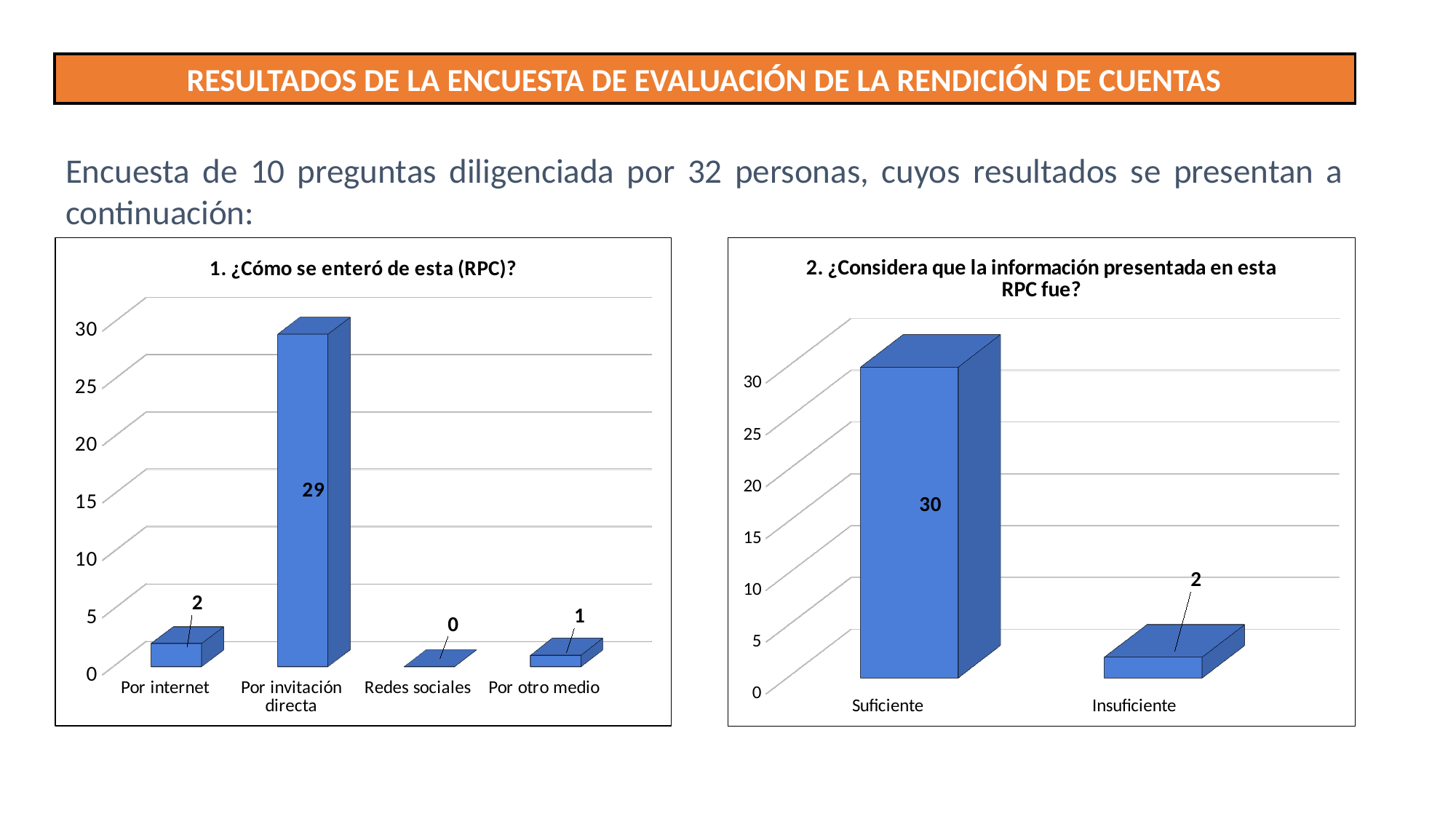
In the chart titled "1. ¿Cómo se enteró de esta (RPC)?", which is larger, "Por internet" or "Por otro medio"? Por internet In the chart titled "2. ¿Considera que la información presentada en esta RPC fue?", what is the value for "Insuficiente"? 2 In the chart titled "1. ¿Cómo se enteró de esta (RPC)?", what is the difference between "Por invitación directa" and "Por internet"? 27 In the chart titled "1. ¿Cómo se enteró de esta (RPC)?", what is the value for "Por internet"? 2 In the chart titled "1. ¿Cómo se enteró de esta (RPC)?", which category has the highest value? Por invitación directa In the chart titled "2. ¿Considera que la información presentada en esta RPC fue?", what is the value for "Suficiente"? 30 In the chart titled "2. ¿Considera que la información presentada en esta RPC fue?", how many categories are shown? 2 What kind of chart is the chart on the right of the slide? Bar chart In the chart titled "1. ¿Cómo se enteró de esta (RPC)?", what is the value for "Por invitación directa"? 29 In the chart titled "2. ¿Considera que la información presentada en esta RPC fue?", what is the difference between "Suficiente" and "Insuficiente"? 28 In the chart titled "1. ¿Cómo se enteró de esta (RPC)?", how many categories are shown? 4 In the chart titled "1. ¿Cómo se enteró de esta (RPC)?", which category has the lowest value? Redes sociales